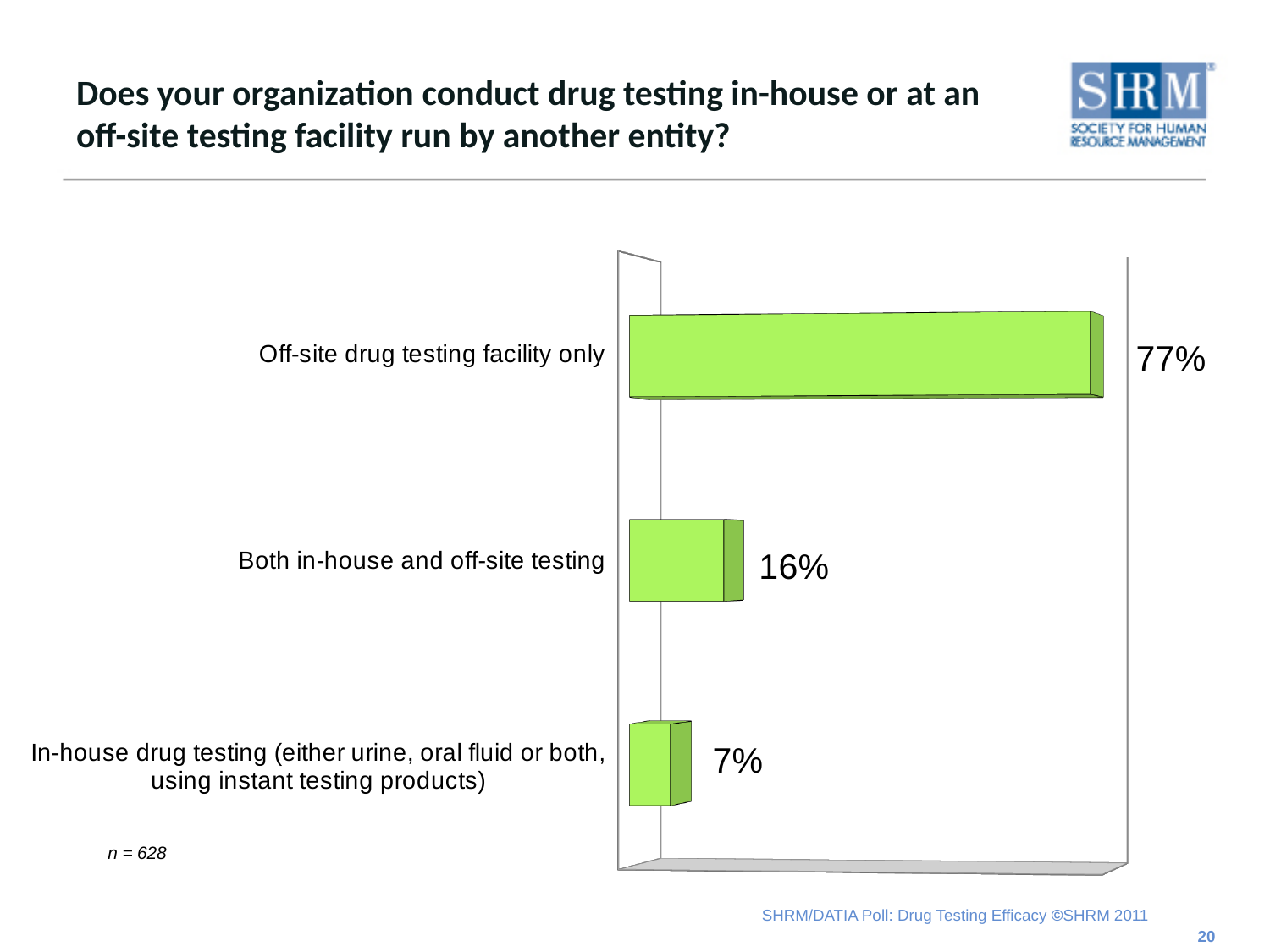
What percentage of organizations use both in-house and off-site testing? 16% What is the sample size (n) shown on the slide? n = 628 Which category has the highest percentage? Off-site drug testing facility only What is the difference in percentage points between 'Off-site drug testing facility only' and 'Both in-house and off-site testing'? 61 What percentage of organizations use an off-site drug testing facility only? 77% What colour are the bars in the chart? Green What is the difference in percentage points between 'Both in-house and off-site testing' and 'In-house drug testing'? 9 How many categories are shown in the chart? 3 Which is larger: the value for 'Both in-house and off-site testing' or the value for 'In-house drug testing'? Both in-house and off-site testing What kind of chart is shown on the slide? Bar chart What percentage of organizations conduct in-house drug testing (either urine, oral fluid or both, using instant testing products)? 7% Which category has the lowest percentage? In-house drug testing (either urine, oral fluid or both, using instant testing products)